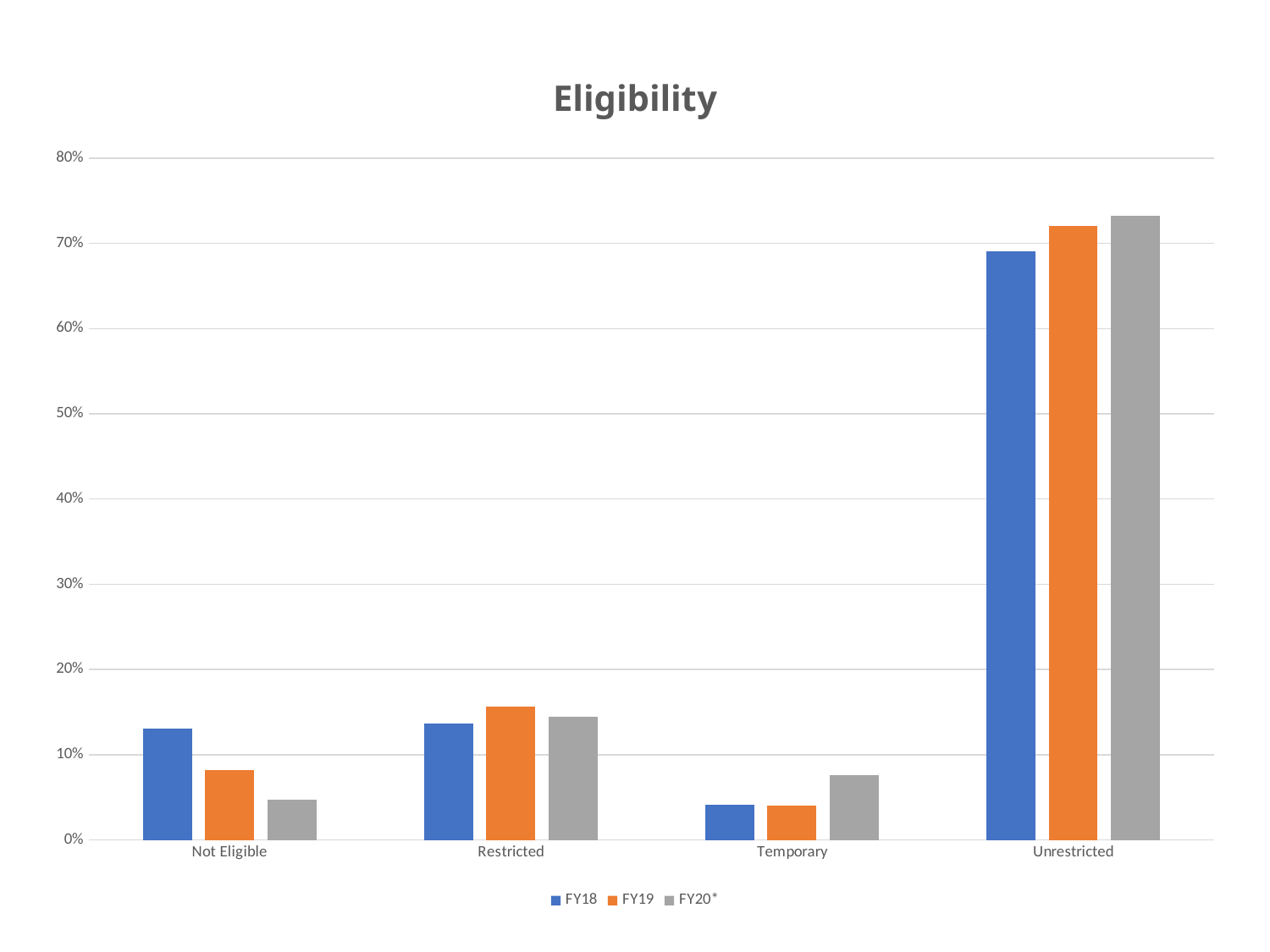
How many series does the legend list? 3 Is the FY18 value for Unrestricted greater or less than 60%? greater Is the FY20* value for Not Eligible greater or less than 10%? less Do the Not Eligible values rise or fall from FY18 to FY20*? fall Which category has the highest FY18 value? Unrestricted For Not Eligible, which is larger: the FY18 value or the FY19 value? FY18 For Temporary, which is larger: the FY18 value or the FY20* value? FY20* Is the FY19 value for Restricted greater or less than 10%? greater How many categories are shown on the x axis? 4 What is the title of the chart? Eligibility Which category has the lowest FY19 value? Temporary What kind of chart is shown on the slide? bar chart